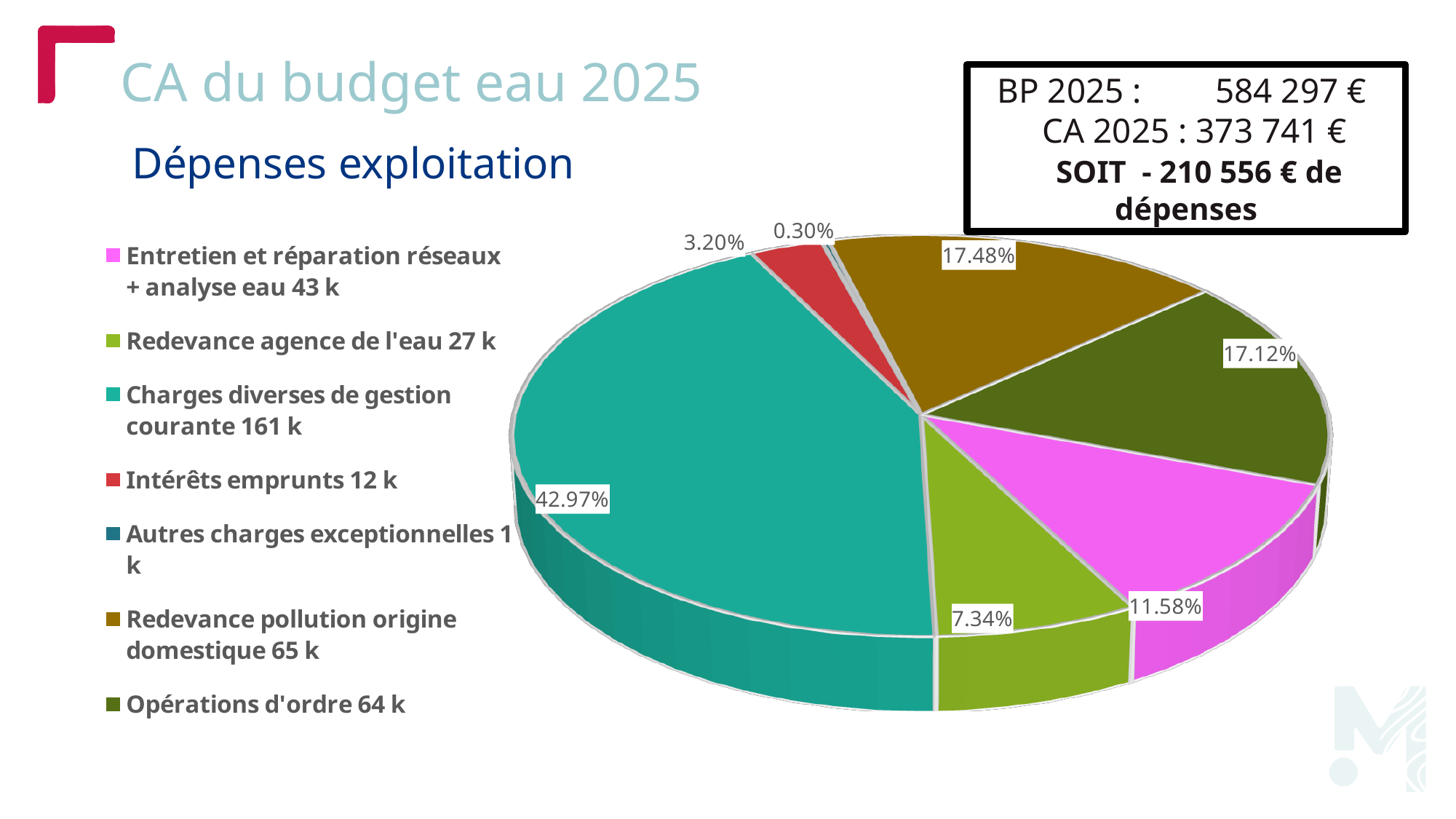
What value is shown in the legend for "Redevance agence de l'eau"? 27 k What share of the pie does "Entretien et réparation réseaux + analyse eau" represent? 11.58% What kind of chart is shown on the slide? pie chart What share of the pie does "Charges diverses de gestion courante" represent? 42.97% Which category has the smallest slice of the pie? Autres charges exceptionnelles What share of the pie does "Redevance pollution origine domestique" represent? 17.48% Which category has the largest slice of the pie? Charges diverses de gestion courante How many slices does the pie chart have? 7 What is the difference in percentage points between the "Charges diverses de gestion courante" slice and the "Entretien et réparation réseaux + analyse eau" slice? 31.39 What colour is the slice for "Intérêts emprunts"? red